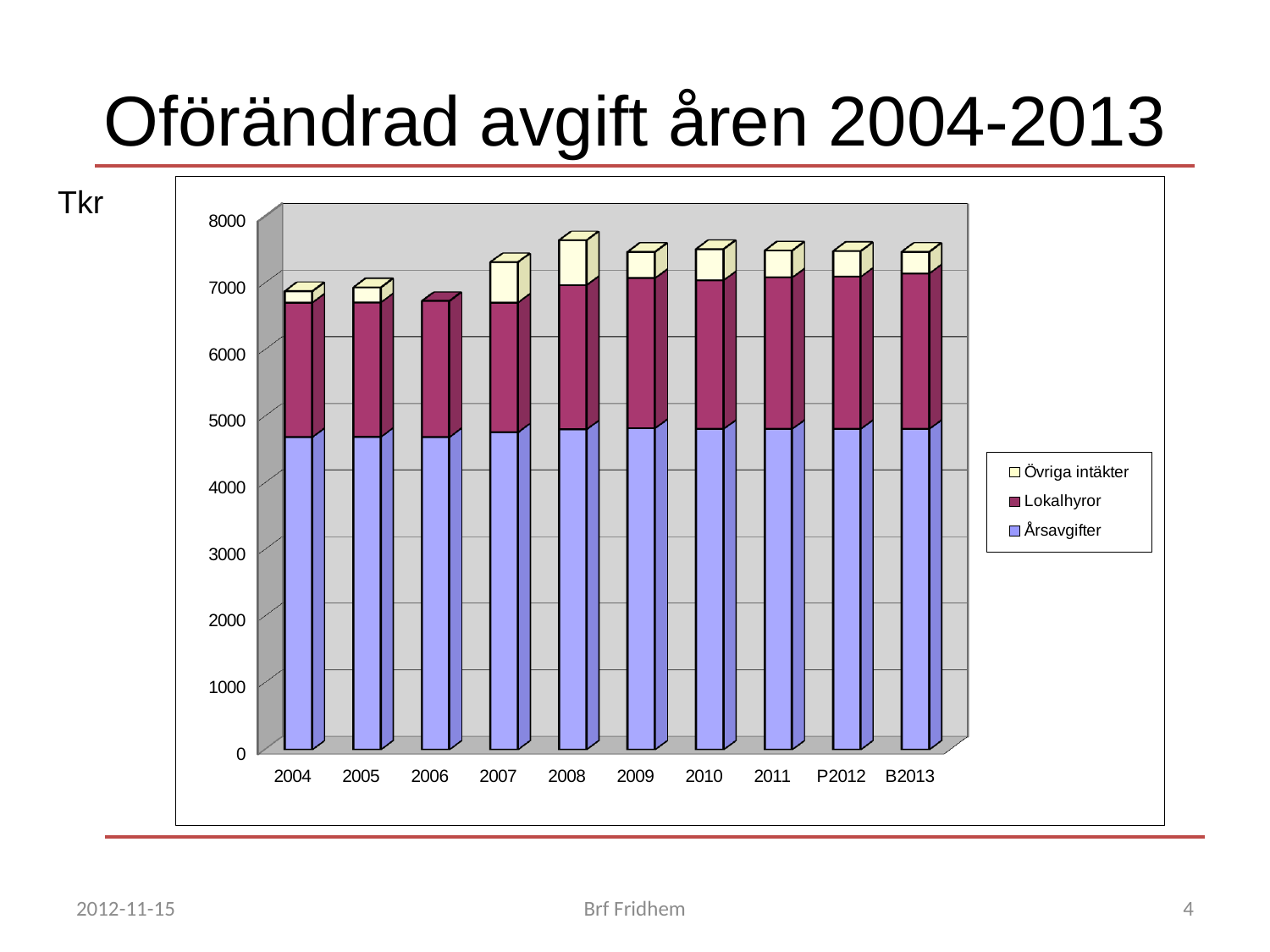
What kind of chart is shown on the slide? Stacked bar chart How many series does the legend list? 3 What is the title of the slide containing the chart? Oförändrad avgift åren 2004-2013 Which year has the highest total bar? 2008 How many categories are shown along the x axis? 10 Is the Årsavgifter value for 2010 greater or less than 4000? greater Is the total bar for 2006 greater or less than 7000? less Is the Årsavgifter value for 2004 greater or less than 5000? less Which year has the lowest total bar? 2006 Which total bar is larger, 2007 or 2006? 2007 Which series is shown at the bottom of each stacked bar? Årsavgifter